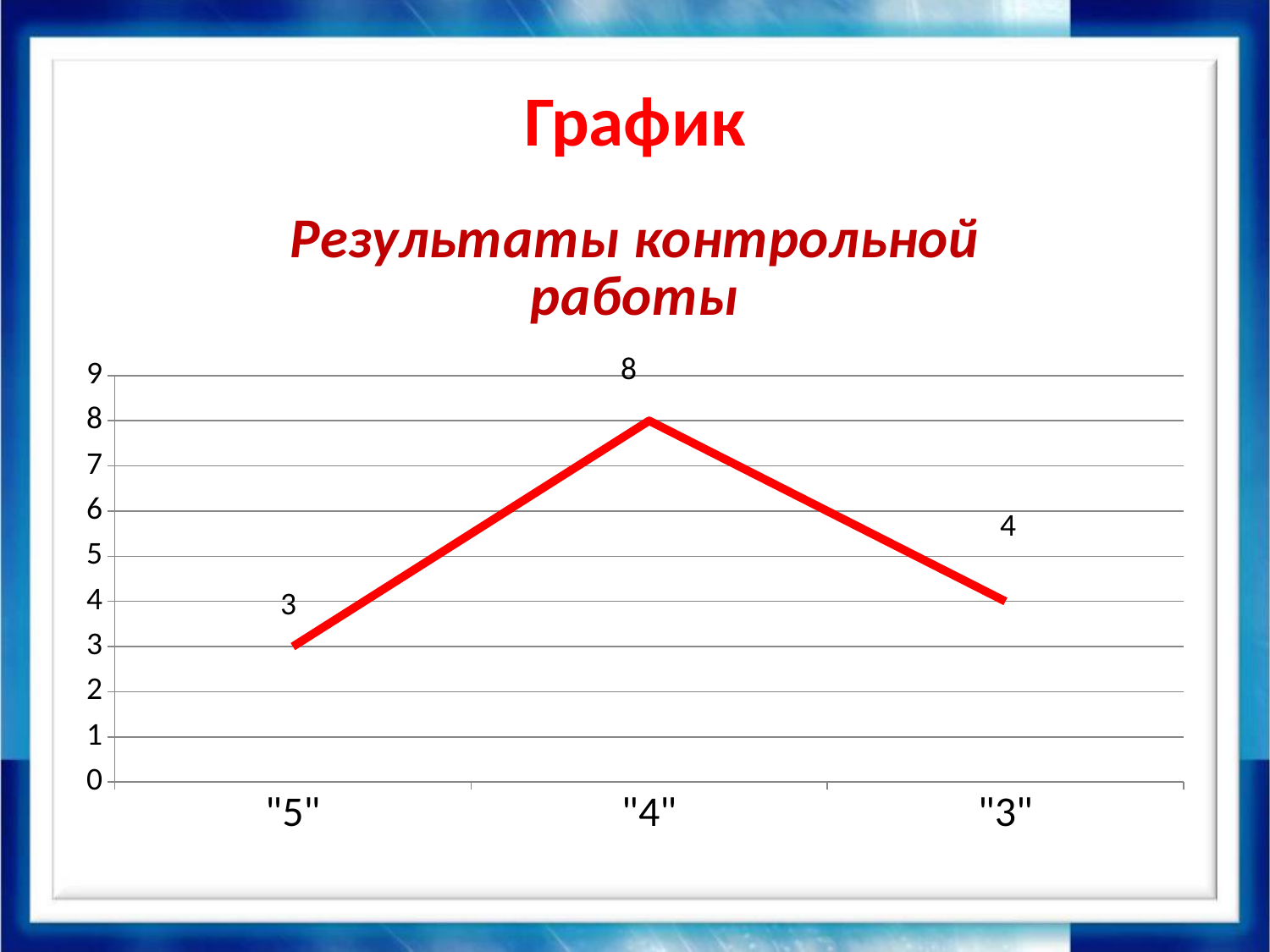
What is the difference between the values for "4" and "5"? 5 What is the difference between the values for "4" and "3"? 4 Which category has the lowest value? "5" What is the value for the "3" category? 4 What kind of chart is shown on the slide? line chart What is the value for the "4" category? 8 Which category has the highest value? "4" Which is larger, the value for "3" or the value for "5"? "3" What is the title of the chart? Результаты контрольной работы Is the value for "4" greater or less than 6? greater How many categories are shown on the x axis? 3 What is the value for the "5" category? 3